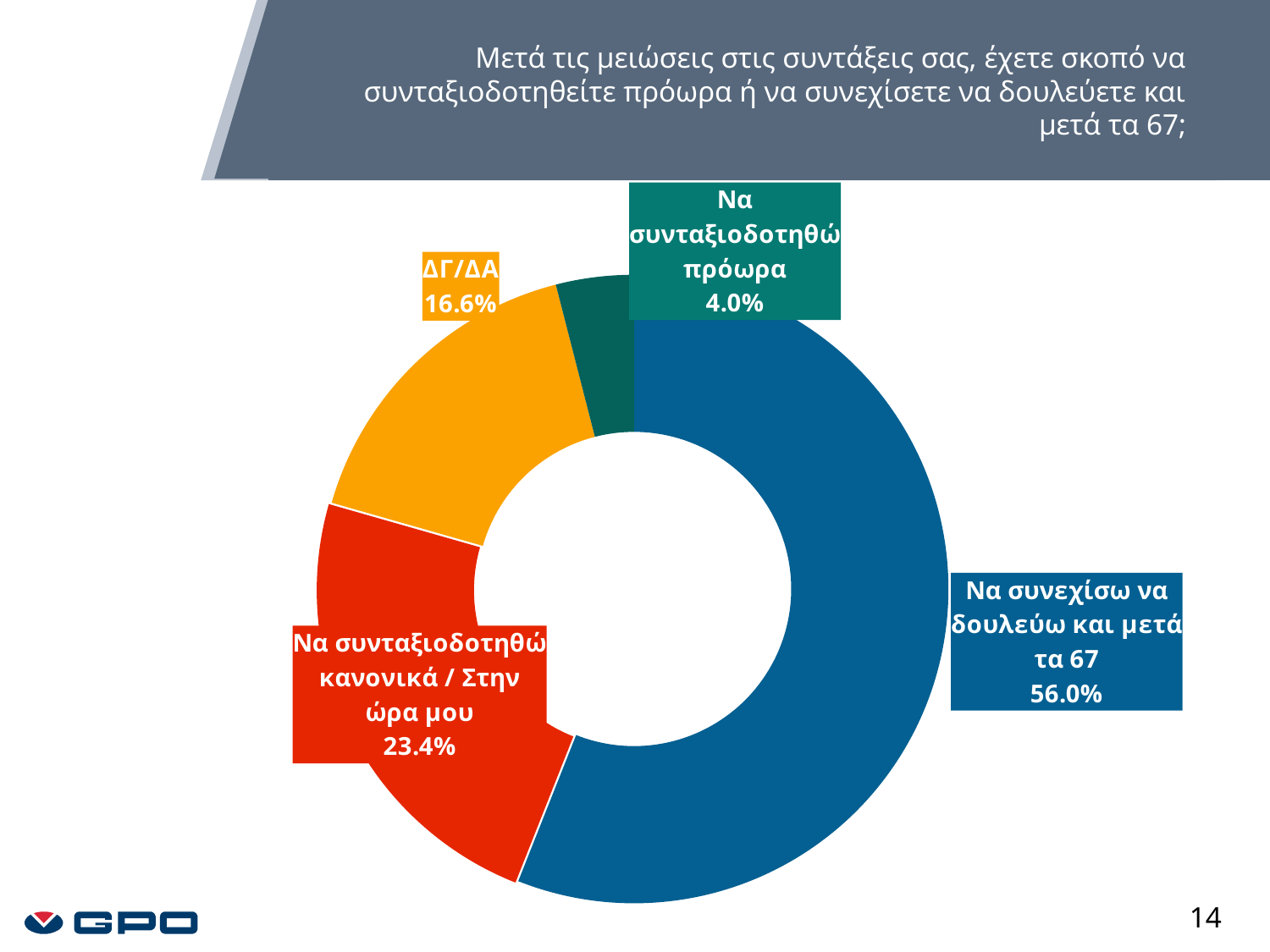
What is the difference in percentage points between 'Να συνεχίσω να δουλεύω και μετά τα 67' and 'Να συνταξιοδοτηθώ κανονικά / Στην ώρα μου'? 32.6 What colour is the segment for 'Να συνεχίσω να δουλεύω και μετά τα 67'? Blue Which response has the largest share of the chart? Να συνεχίσω να δουλεύω και μετά τα 67 What percentage of respondents answered 'ΔΓ/ΔΑ'? 16.6% Which response has the smallest share of the chart? Να συνταξιοδοτηθώ πρόωρα What percentage of respondents answered 'Να συνεχίσω να δουλεύω και μετά τα 67'? 56.0% What percentage of respondents answered 'Να συνταξιοδοτηθώ κανονικά / Στην ώρα μου'? 23.4% Which is larger: the share for 'Να συνταξιοδοτηθώ κανονικά / Στην ώρα μου' or the share for 'ΔΓ/ΔΑ'? Να συνταξιοδοτηθώ κανονικά / Στην ώρα μου What kind of chart is shown on the slide? Pie chart (doughnut) What percentage of respondents answered 'Να συνταξιοδοτηθώ πρόωρα'? 4.0% What is the difference in percentage points between 'ΔΓ/ΔΑ' and 'Να συνταξιοδοτηθώ πρόωρα'? 12.6 How many response categories are shown in the chart? 4